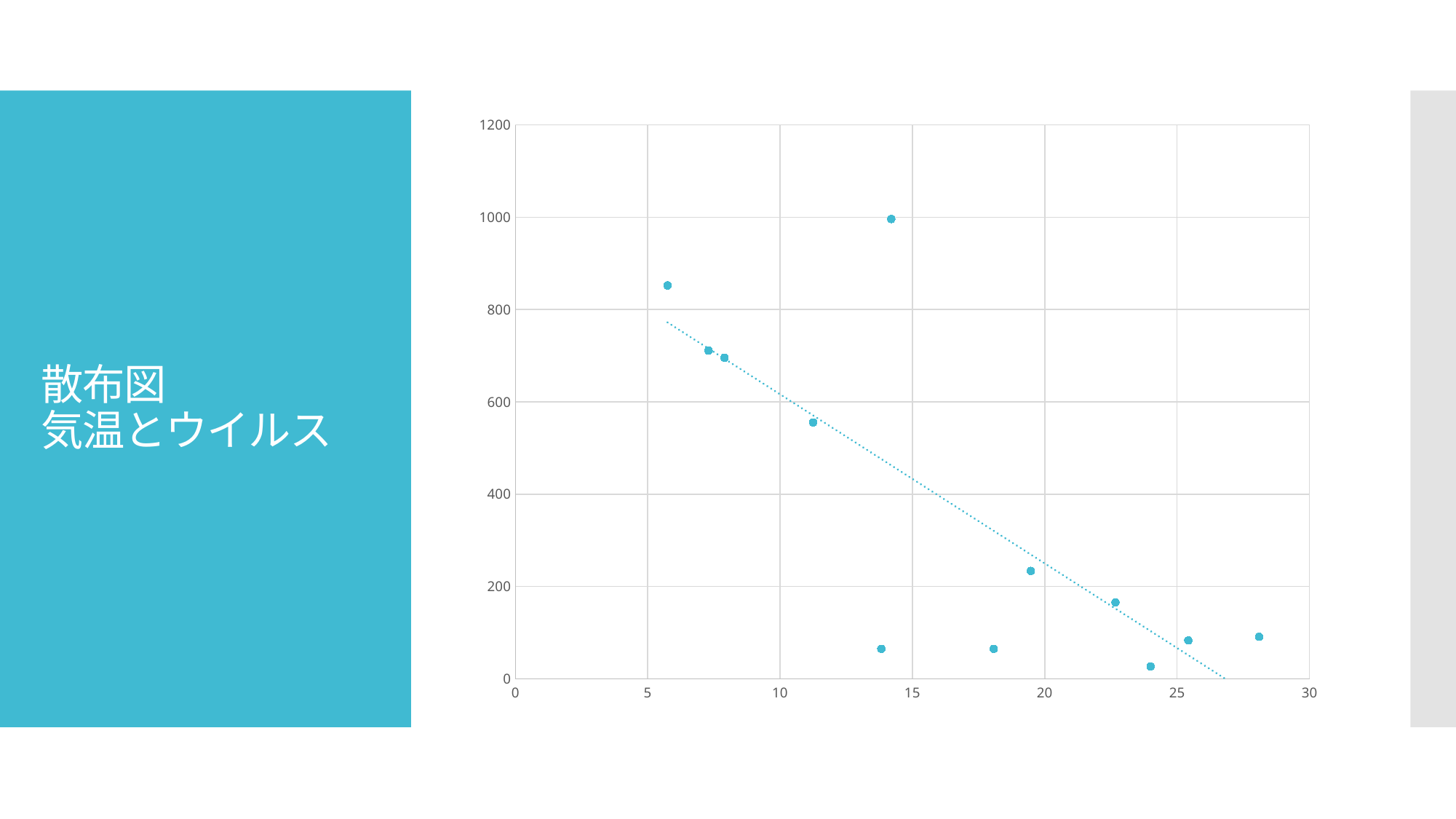
What is the highest value shown on the x axis? 30 Is the y value of the point near x=11 greater or less than 600? less How many data points are plotted on the chart? 12 What kind of chart is shown on the slide? scatter chart Which point has the higher y value: the one near x=14 at the top of the chart or the one near x=6? the one near x=14 Is the y value of the point near x=19.5 greater or less than 200? greater Is the y value of the point near x=14 at the top of the chart greater or less than 800? greater What is the highest value shown on the y axis? 1200 Does the dotted trend line slope upward or downward from left to right? downward Do the plotted values generally rise or fall as the x value increases? fall